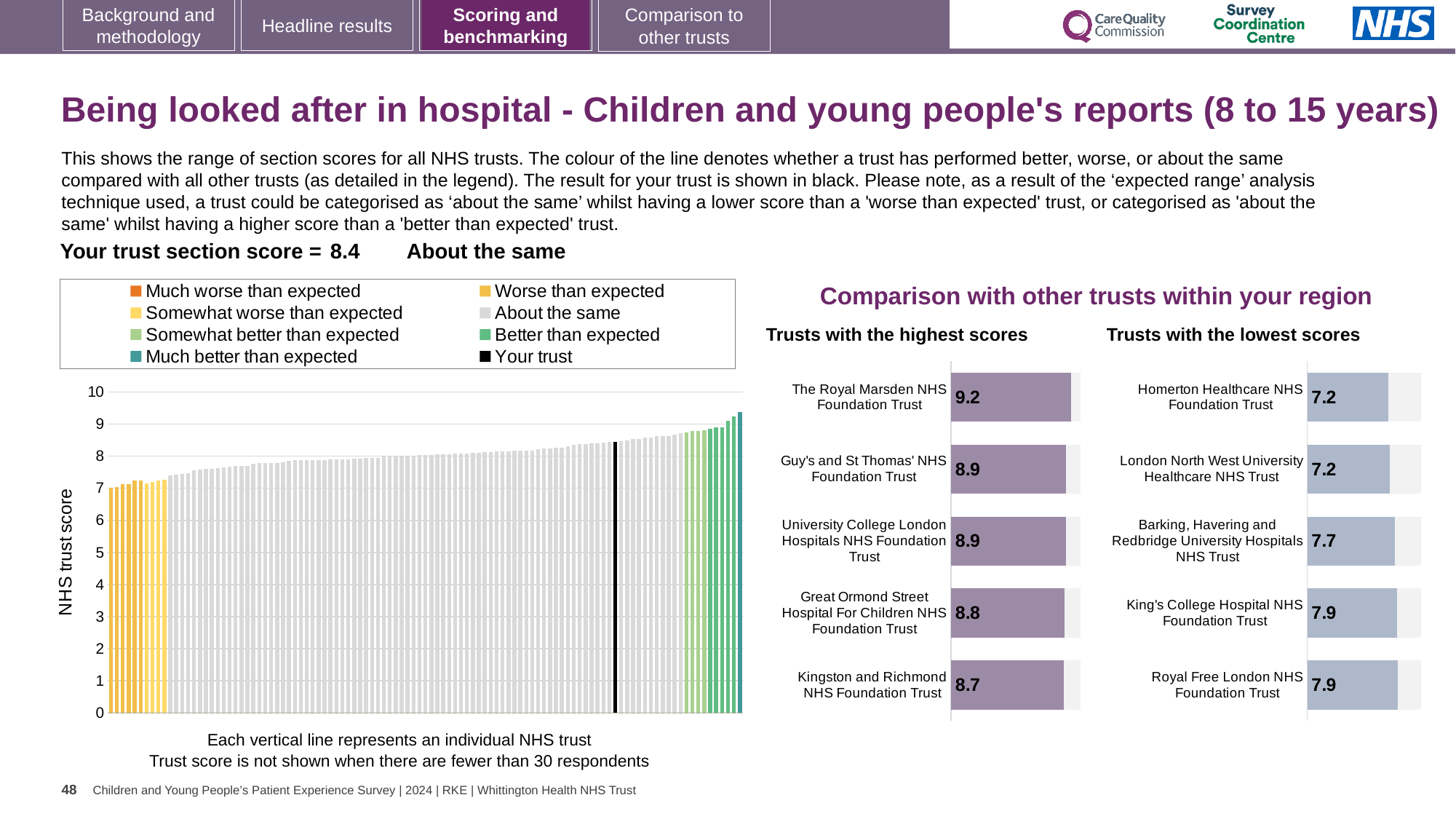
In the 'Trusts with the lowest scores' chart, what is the score for Homerton Healthcare NHS Foundation Trust? 7.2 In the 'Trusts with the lowest scores' chart, what is the difference between the scores of Royal Free London NHS Foundation Trust and London North West University Healthcare NHS Trust? 0.7 How many entries does the legend of the large chart on the left list? 8 In the 'Trusts with the highest scores' chart, which trust has the highest score? The Royal Marsden NHS Foundation Trust In the 'Trusts with the highest scores' chart, what is the score for The Royal Marsden NHS Foundation Trust? 9.2 How many trusts are shown in the 'Trusts with the highest scores' chart? 5 In the 'Trusts with the highest scores' chart, what is the score for Kingston and Richmond NHS Foundation Trust? 8.7 In the large chart on the left, is the value for the black 'Your trust' bar greater or less than 8? greater In the 'Trusts with the lowest scores' chart, which is larger: the score for King's College Hospital NHS Foundation Trust or the score for Homerton Healthcare NHS Foundation Trust? King's College Hospital NHS Foundation Trust In the 'Trusts with the lowest scores' chart, what is the score for Barking, Havering and Redbridge University Hospitals NHS Trust? 7.7 In the 'Trusts with the highest scores' chart, what is the difference between the scores of The Royal Marsden NHS Foundation Trust and Kingston and Richmond NHS Foundation Trust? 0.5 What kind of chart is the large chart on the left showing NHS trust scores? Bar chart